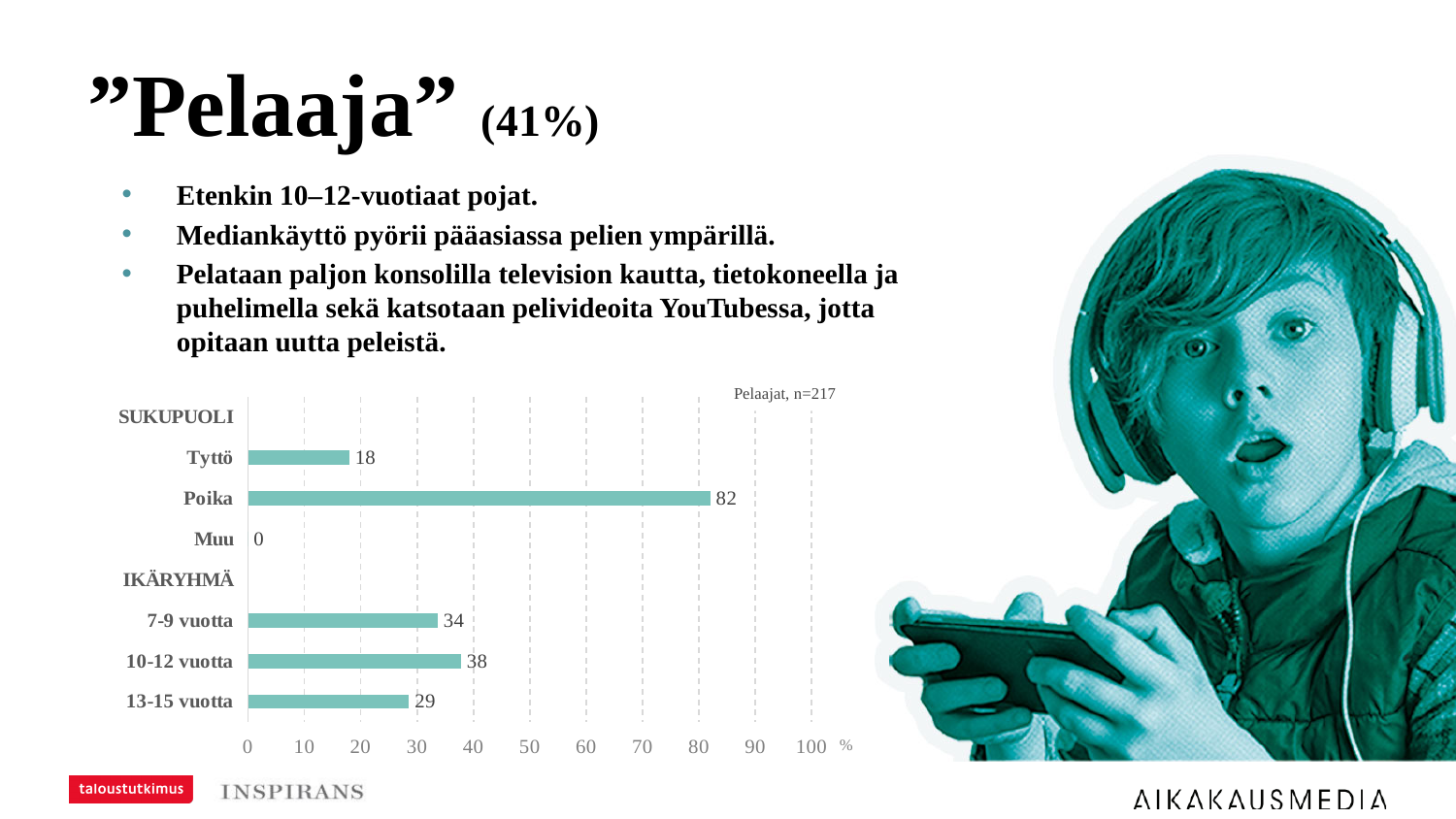
What is the difference between the values for Poika and Tyttö? 64 Which is larger, the value for 7-9 vuotta or the value for 13-15 vuotta? 7-9 vuotta Which age group (IKÄRYHMÄ) has the highest value? 10-12 vuotta What is the value for 10-12 vuotta in the chart? 38 What is the sample size (n) stated on the chart? n=217 Which age group (IKÄRYHMÄ) has the lowest value? 13-15 vuotta What is the difference between the values for 10-12 vuotta and 7-9 vuotta? 4 What is the value for Poika in the chart? 82 What is the value for 13-15 vuotta in the chart? 29 What is the value for Tyttö in the chart? 18 What is the value for Muu in the chart? 0 What kind of chart is shown on the slide? Bar chart